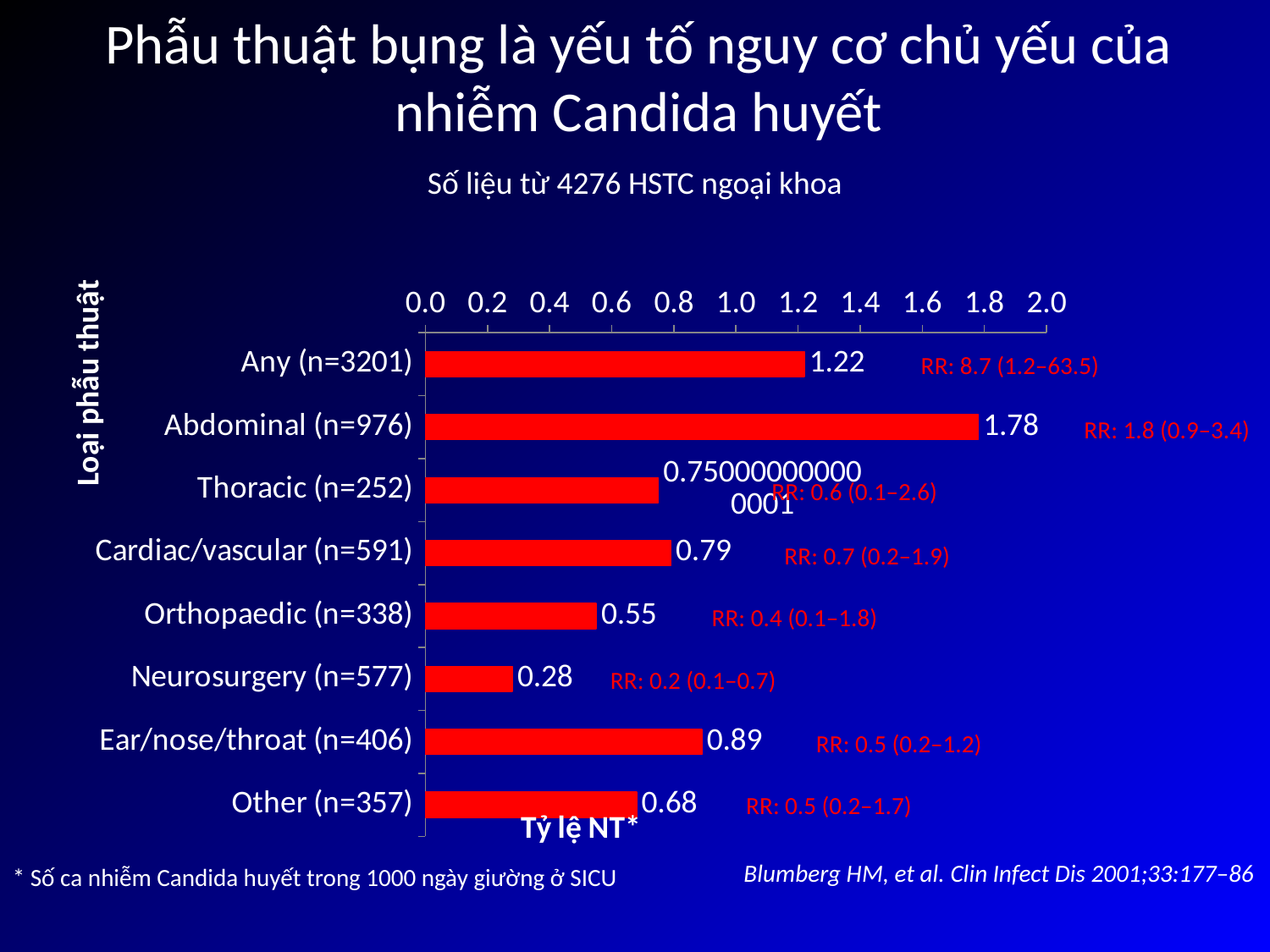
What is the value for Neurosurgery (n=577)? 0.28 What is the value for Any (n=3201)? 1.22 Which is larger, the value for Cardiac/vascular (n=591) or Orthopaedic (n=338)? Cardiac/vascular (n=591) What kind of chart is shown on the slide? bar chart Which category has the highest value? Abdominal (n=976) What is the value for Abdominal (n=976)? 1.78 What is the difference between the values for Abdominal (n=976) and Any (n=3201)? 0.56 Is the value for Thoracic (n=252) greater or less than 0.6? greater What is the value for Ear/nose/throat (n=406)? 0.89 How many categories are shown on the chart? 8 Which category has the lowest value? Neurosurgery (n=577) What is the label of the x axis? Tỷ lệ NT*